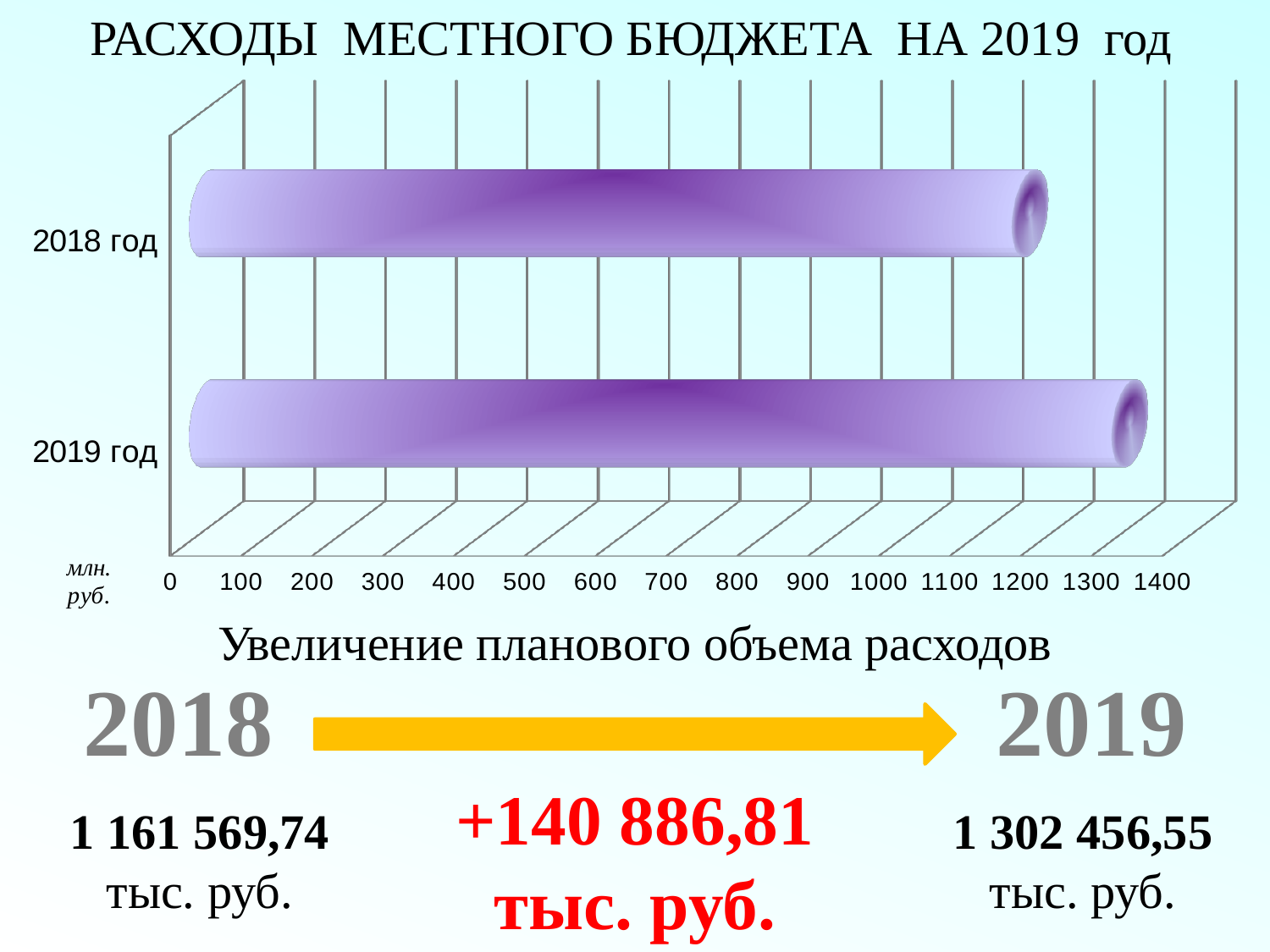
Is the value for 2018 год greater or less than 1100? greater Is the value for 2019 год greater or less than 1200? greater How many categories (years) are plotted in the chart? 2 What kind of chart is shown on the slide? bar chart What unit is shown on the horizontal axis of the chart? млн. руб. According to the text below the chart, by how much did the planned expenditure increase from 2018 to 2019? +140 886,81 тыс. руб. Which year has the higher local budget expenditure in the chart? 2019 год Is the bar for 2019 год longer or shorter than the bar for 2018 год? longer What is the title of the chart? РАСХОДЫ МЕСТНОГО БЮДЖЕТА НА 2019 год Do the expenditures rise or fall from 2018 to 2019? rise Which year has the lower local budget expenditure in the chart? 2018 год